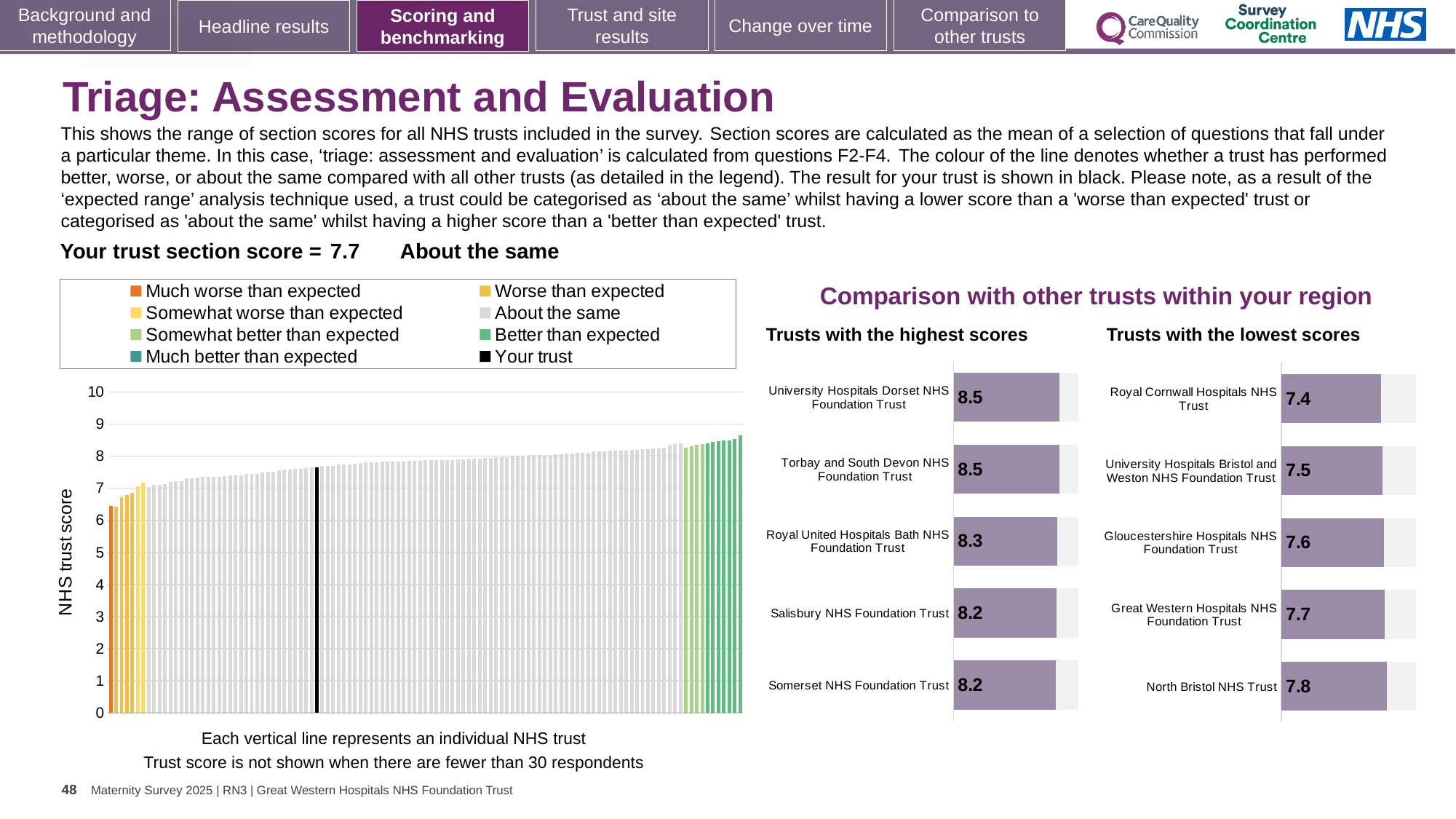
In the main 'NHS trust score' chart on the left, do the bar values rise or fall from left to right? rise In the 'Trusts with the highest scores' chart, what is the score for Salisbury NHS Foundation Trust? 8.2 In the 'Trusts with the lowest scores' chart, which trust has the lowest score? Royal Cornwall Hospitals NHS Trust How many entries does the legend of the main chart on the left list? 8 How many trusts are shown in the 'Trusts with the lowest scores' chart? 5 In the 'Trusts with the highest scores' chart, which has the larger score: Royal United Hospitals Bath NHS Foundation Trust or Somerset NHS Foundation Trust? Royal United Hospitals Bath NHS Foundation Trust In the 'Trusts with the highest scores' chart, what is the score for Royal United Hospitals Bath NHS Foundation Trust? 8.3 In the main 'NHS trust score' chart on the left, is the value for your trust (the black bar) greater or less than 7? greater In the 'Trusts with the lowest scores' chart, which trust has the highest score? North Bristol NHS Trust In the 'Trusts with the highest scores' chart, what is the difference between the scores of University Hospitals Dorset NHS Foundation Trust and Royal United Hospitals Bath NHS Foundation Trust? 0.2 In the 'Trusts with the lowest scores' chart, what is the difference between the scores of North Bristol NHS Trust and Royal Cornwall Hospitals NHS Trust? 0.4 In the 'Trusts with the lowest scores' chart, what is the score for Gloucestershire Hospitals NHS Foundation Trust? 7.6